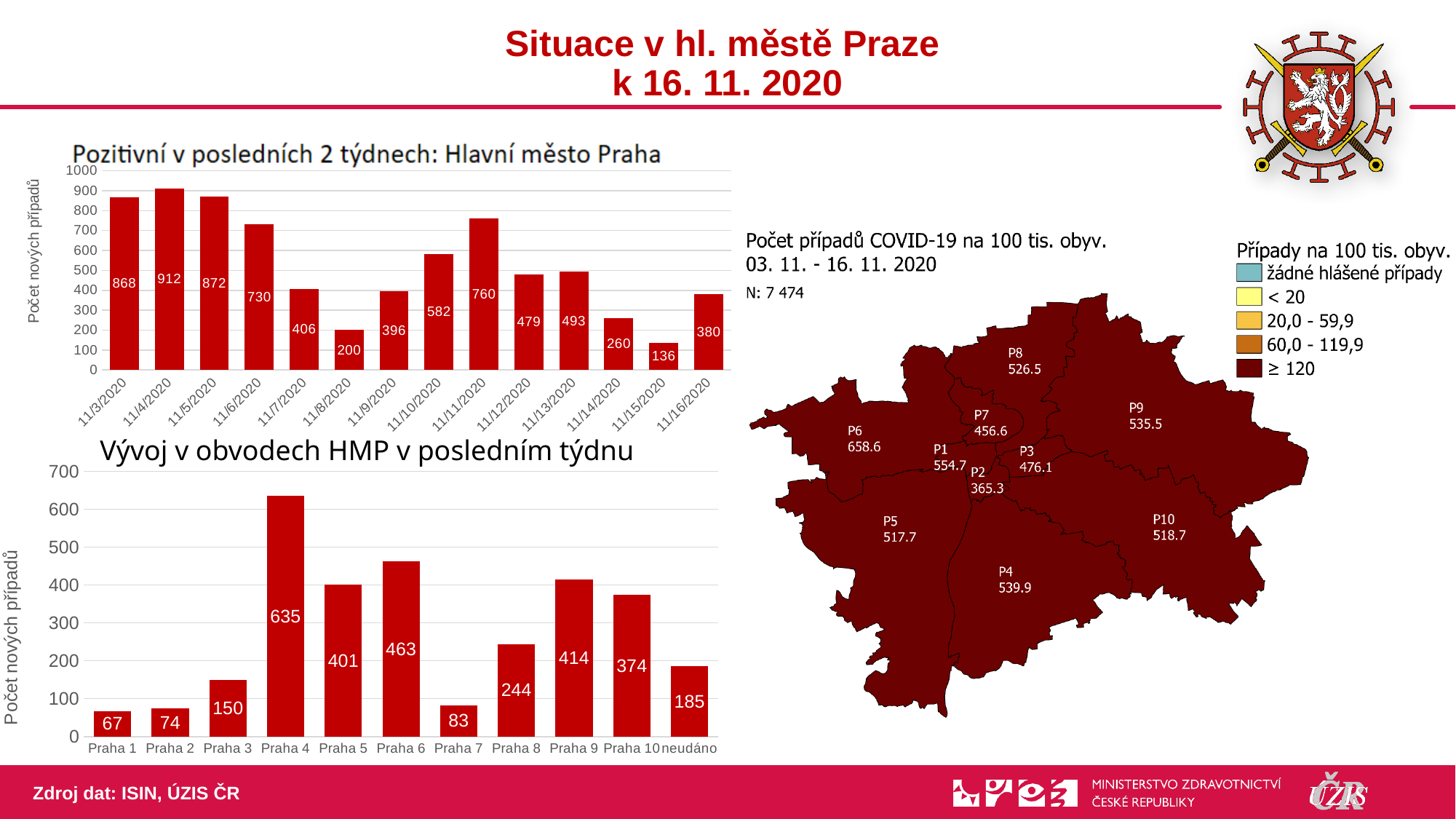
In the bottom chart 'Vývoj v obvodech HMP v posledním týdnu', what is the difference between Praha 4 and Praha 5? 234 In the bottom chart 'Vývoj v obvodech HMP v posledním týdnu', what is the value for Praha 6? 463 In the top chart 'Pozitivní v posledních 2 týdnech', which date has the lowest value? 11/15/2020 In the top chart 'Pozitivní v posledních 2 týdnech', what is the difference between the values for 11/3/2020 and 11/16/2020? 488 In the top chart 'Pozitivní v posledních 2 týdnech', which date has the highest value? 11/4/2020 In the bottom chart 'Vývoj v obvodech HMP v posledním týdnu', how many bars are shown? 11 In the bottom chart 'Vývoj v obvodech HMP v posledním týdnu', which district has the highest value? Praha 4 In the top chart 'Pozitivní v posledních 2 týdnech', is the value for 11/11/2020 larger or smaller than the value for 11/10/2020? larger In the top chart 'Pozitivní v posledních 2 týdnech', how many dates are plotted? 14 In the bottom chart 'Vývoj v obvodech HMP v posledním týdnu', which category has the lowest value? Praha 1 In the top chart 'Pozitivní v posledních 2 týdnech: Hlavní město Praha', what is the value for 11/4/2020? 912 What type of chart is the bottom chart 'Vývoj v obvodech HMP v posledním týdnu'? bar chart